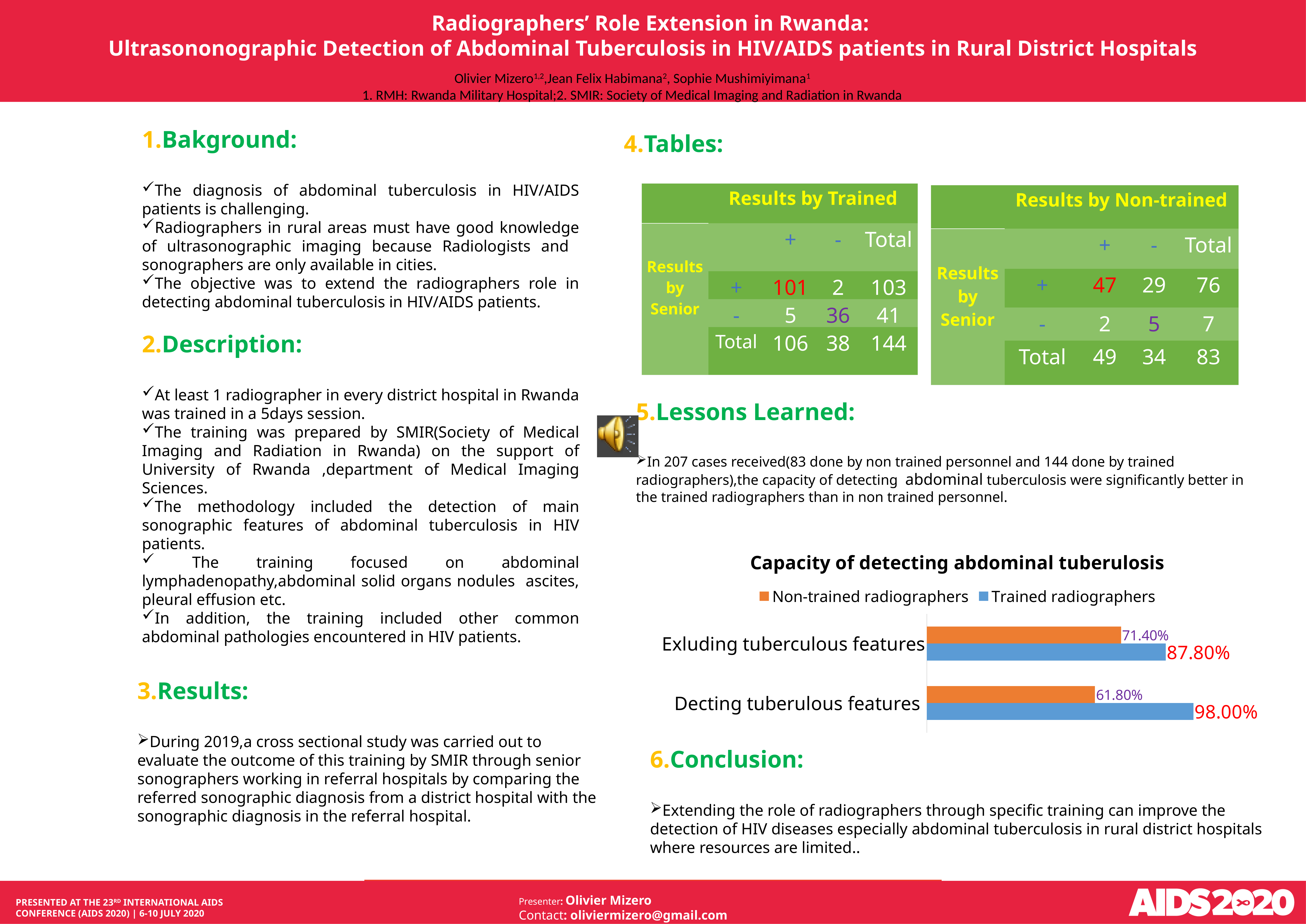
How many categories are shown on the chart? 2 What is the difference between Trained and Non-trained radiographers for 'Decting tuberulous features'? 36.20% What is the value for Non-trained radiographers for 'Exluding tuberculous features'? 71.40% What colour represents Non-trained radiographers in the chart? orange Which category has the lowest value for Non-trained radiographers? Decting tuberulous features What is the difference between Trained and Non-trained radiographers for 'Exluding tuberculous features'? 16.40% What is the value for Trained radiographers for 'Exluding tuberculous features'? 87.80% What type of chart is 'Capacity of detecting abdominal tuberulosis'? bar chart What is the value for Trained radiographers for 'Decting tuberulous features'? 98.00% Which series has the higher value for 'Decting tuberulous features'? Trained radiographers How many series does the legend of the chart list? 2 What is the value for Non-trained radiographers for 'Decting tuberulous features'? 61.80%